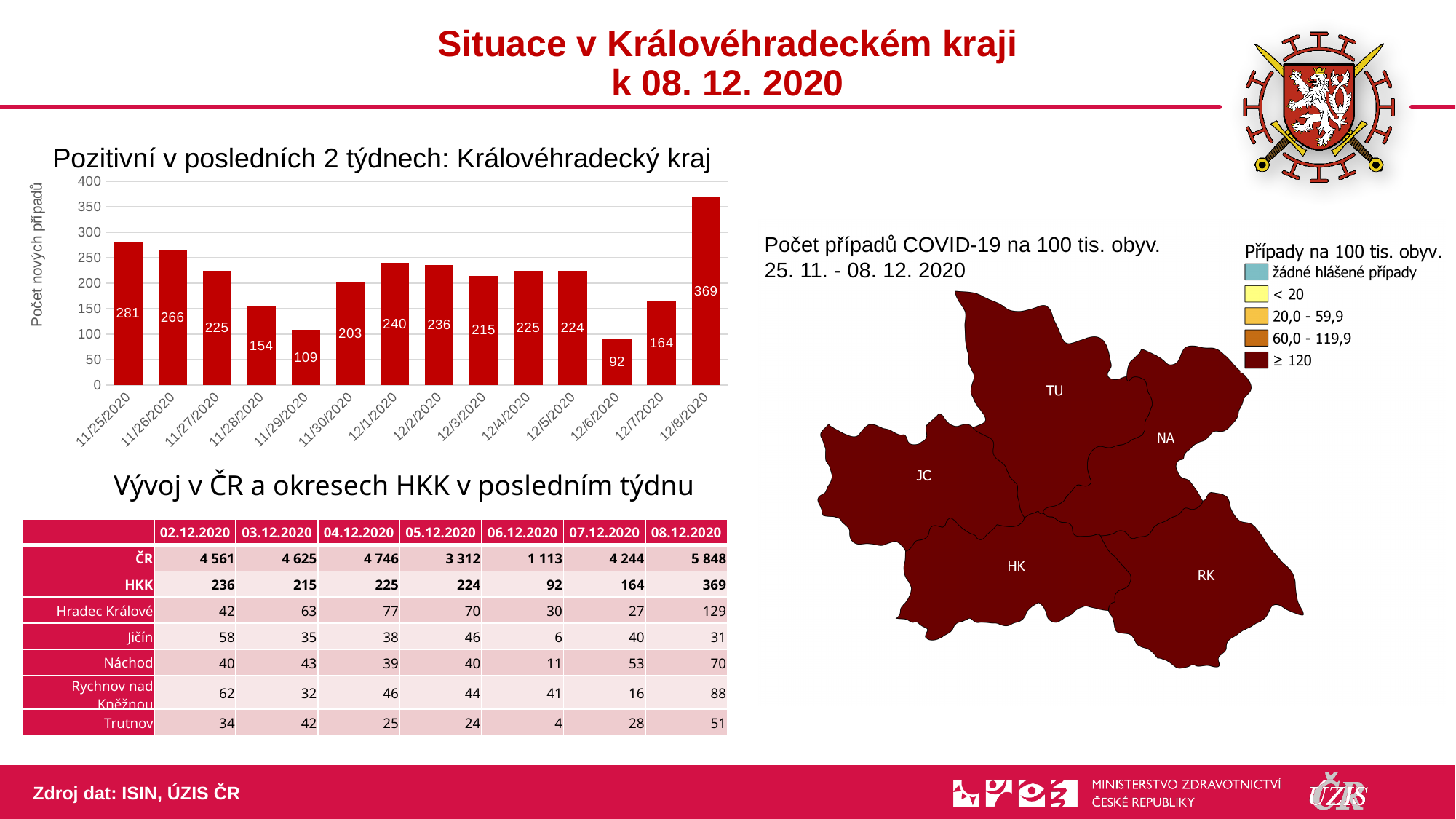
In the bar chart, is the value for 12/8/2020 greater or less than 350? greater In the bar chart, what is the value for 11/29/2020? 109 Which date has the highest value in the bar chart? 12/8/2020 How many dates (bars) are shown in the bar chart? 14 In the bar chart, what is the value for 12/1/2020? 240 In the bar chart, what is the difference between the values for 12/8/2020 and 12/7/2020? 205 In the bar chart, what is the value for 11/25/2020? 281 Which date has the lowest value in the bar chart? 12/6/2020 What type of chart is shown under the title 'Pozitivní v posledních 2 týdnech: Královéhradecký kraj'? bar chart In the bar chart, which is larger: the value for 11/28/2020 or the value for 11/30/2020? 11/30/2020 In the bar chart, what is the difference between the values for 11/25/2020 and 11/26/2020? 15 What is the y-axis label of the bar chart? Počet nových případů